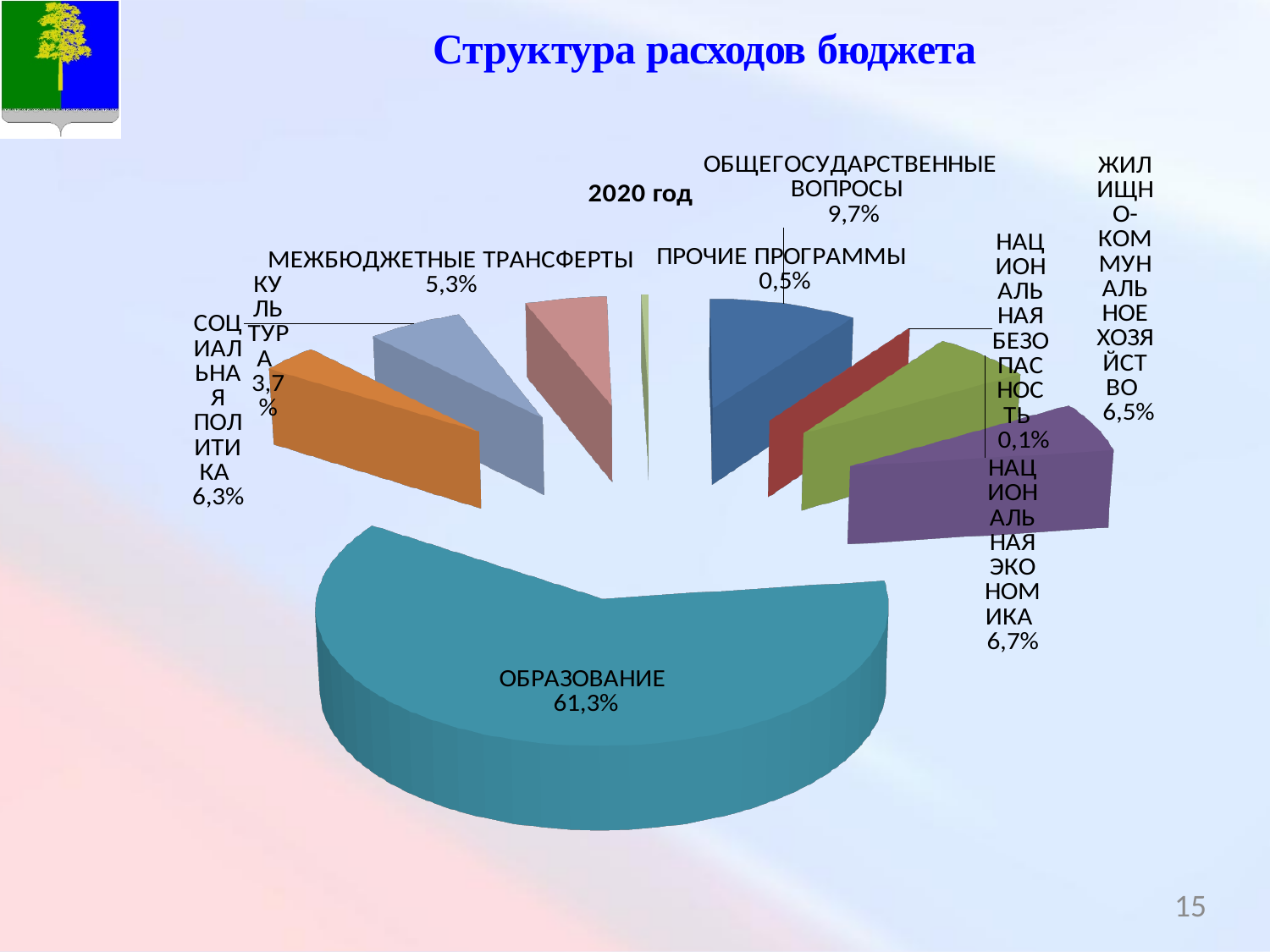
What kind of chart is shown on the slide? pie chart What percentage is shown for МЕЖБЮДЖЕТНЫЕ ТРАНСФЕРТЫ? 5,3% Which category has the largest share of the pie? ОБРАЗОВАНИЕ What is the difference between the shares of ОБРАЗОВАНИЕ and ОБЩЕГОСУДАРСТВЕННЫЕ ВОПРОСЫ? 51,6% What share of budget expenditure does ОБРАЗОВАНИЕ account for? 61,3% What is the value shown for ОБЩЕГОСУДАРСТВЕННЫЕ ВОПРОСЫ? 9,7% What is the title of the chart on the slide? 2020 год How many slices does the pie chart have? 9 Which category has the smallest share of the pie? НАЦИОНАЛЬНАЯ БЕЗОПАСНОСТЬ What share is shown for КУЛЬТУРА? 3,7% What is the value for НАЦИОНАЛЬНАЯ ЭКОНОМИКА? 6,7% Which is larger, the share of СОЦИАЛЬНАЯ ПОЛИТИКА or the share of МЕЖБЮДЖЕТНЫЕ ТРАНСФЕРТЫ? СОЦИАЛЬНАЯ ПОЛИТИКА